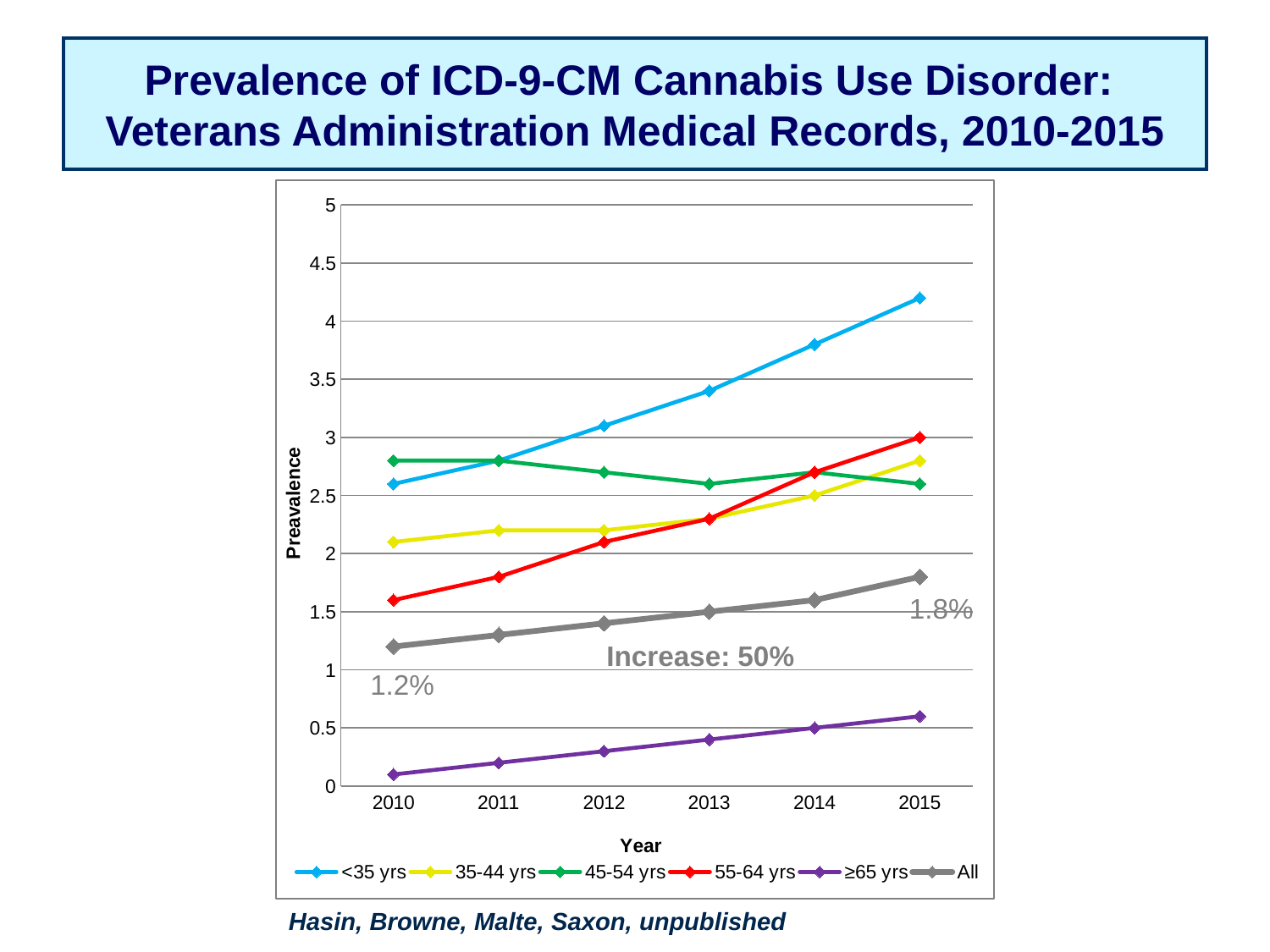
How many series does the legend list? 6 What is the labelled value for the All series in 2010? 1.2% Is the prevalence for ≥65 yrs in 2010 greater or less than 0.5? less In 2015, which is larger: the prevalence for 55-64 yrs or for 45-54 yrs? 55-64 yrs What is the labelled value for the All series in 2015? 1.8% What kind of chart is shown on the slide? line chart Does the prevalence for <35 yrs rise or fall from 2010 to 2015? rise Which age group has the highest prevalence in 2015? <35 yrs Which age group has the lowest prevalence in 2015? ≥65 yrs Is the prevalence for <35 yrs in 2015 greater or less than 4? greater How many years are plotted along the x axis? 6 What percentage increase is annotated on the chart for the All series? 50%